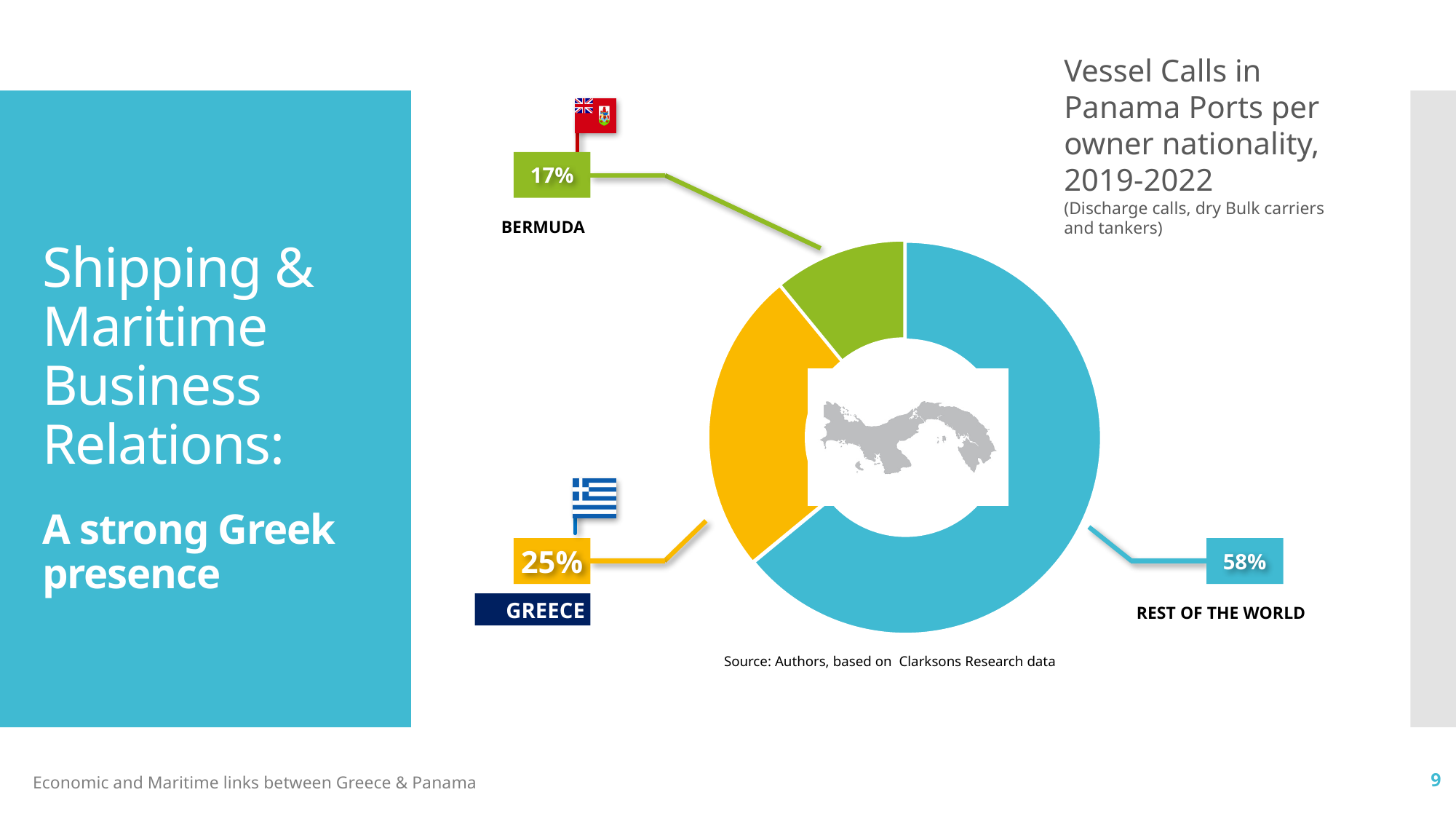
What share of vessel calls in Panama ports is attributed to Greek owners? 25% What share of vessel calls in Panama ports is attributed to Bermuda owners? 17% What colour is the Greece slice of the chart? Yellow/orange What is the difference in percentage points between the Greece share and the Bermuda share? 8 What share of vessel calls in Panama ports is attributed to the Rest of the World? 58% How many categories are shown in the chart? 3 What is the title of the chart? Vessel Calls in Panama Ports per owner nationality, 2019-2022 Which category has the smallest share of vessel calls in Panama ports? Bermuda What kind of chart is used to show vessel calls per owner nationality? Pie chart (doughnut) Which category has the largest share of vessel calls in Panama ports? Rest of the World What is the difference in percentage points between the Rest of the World share and the Greece share? 33 Which has a larger share of vessel calls, Greece or Bermuda? Greece